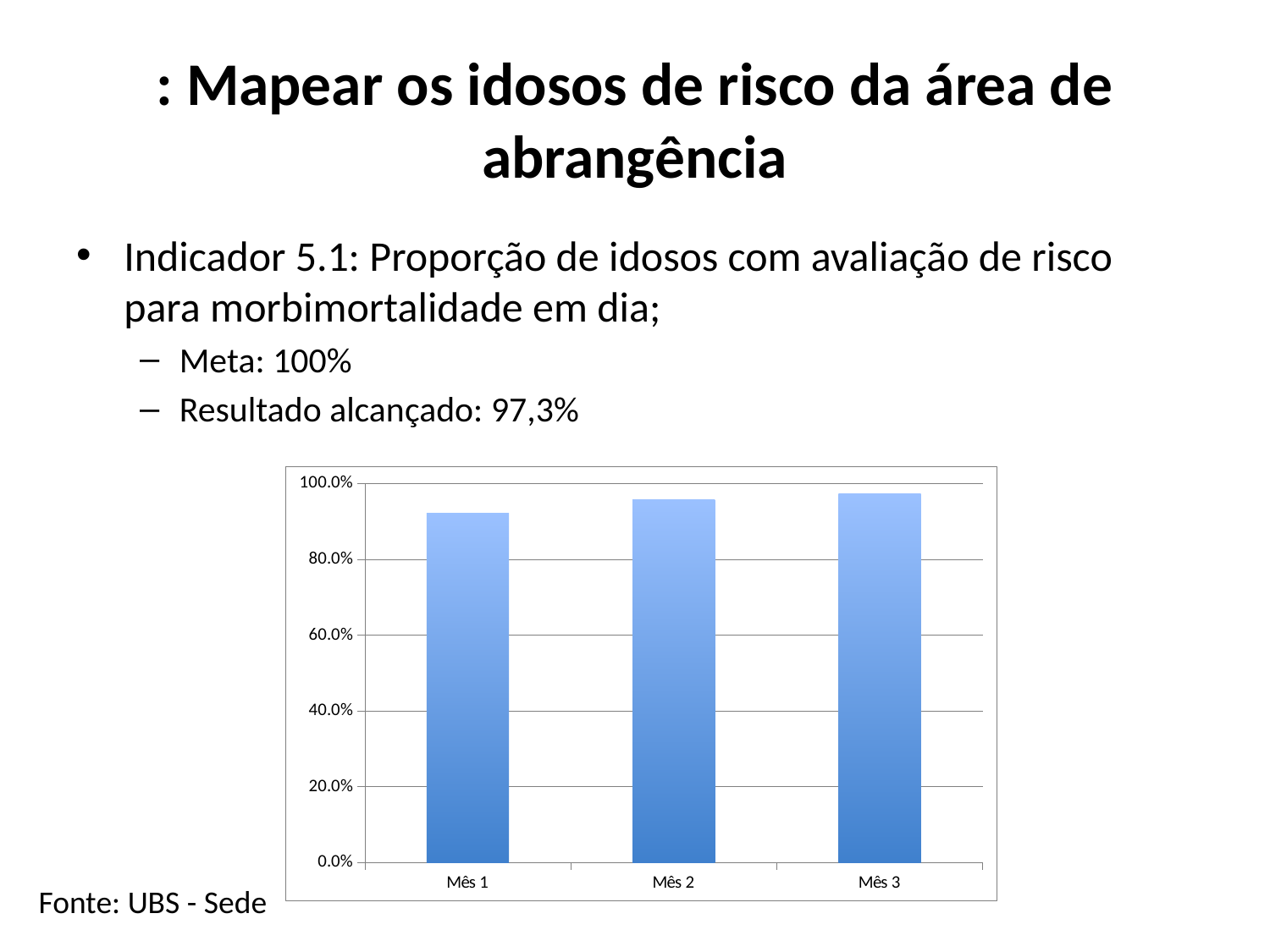
Is the value for Mês 3 greater or less than 100.0%? less What kind of chart is shown on the slide? bar chart Which category has the lowest bar in the chart? Mês 1 Is the value for Mês 1 greater or less than 80.0%? greater What is the highest tick label shown on the vertical axis of the chart? 100.0% Do the values rise or fall from Mês 1 to Mês 3? rise What colour are the bars in the chart? blue Is the value for Mês 2 greater or less than 60.0%? greater Which category has the highest bar in the chart? Mês 3 Which is larger, the value for Mês 1 or the value for Mês 2? Mês 2 Which is larger, the value for Mês 1 or the value for Mês 3? Mês 3 How many bars (categories) does the chart show? 3